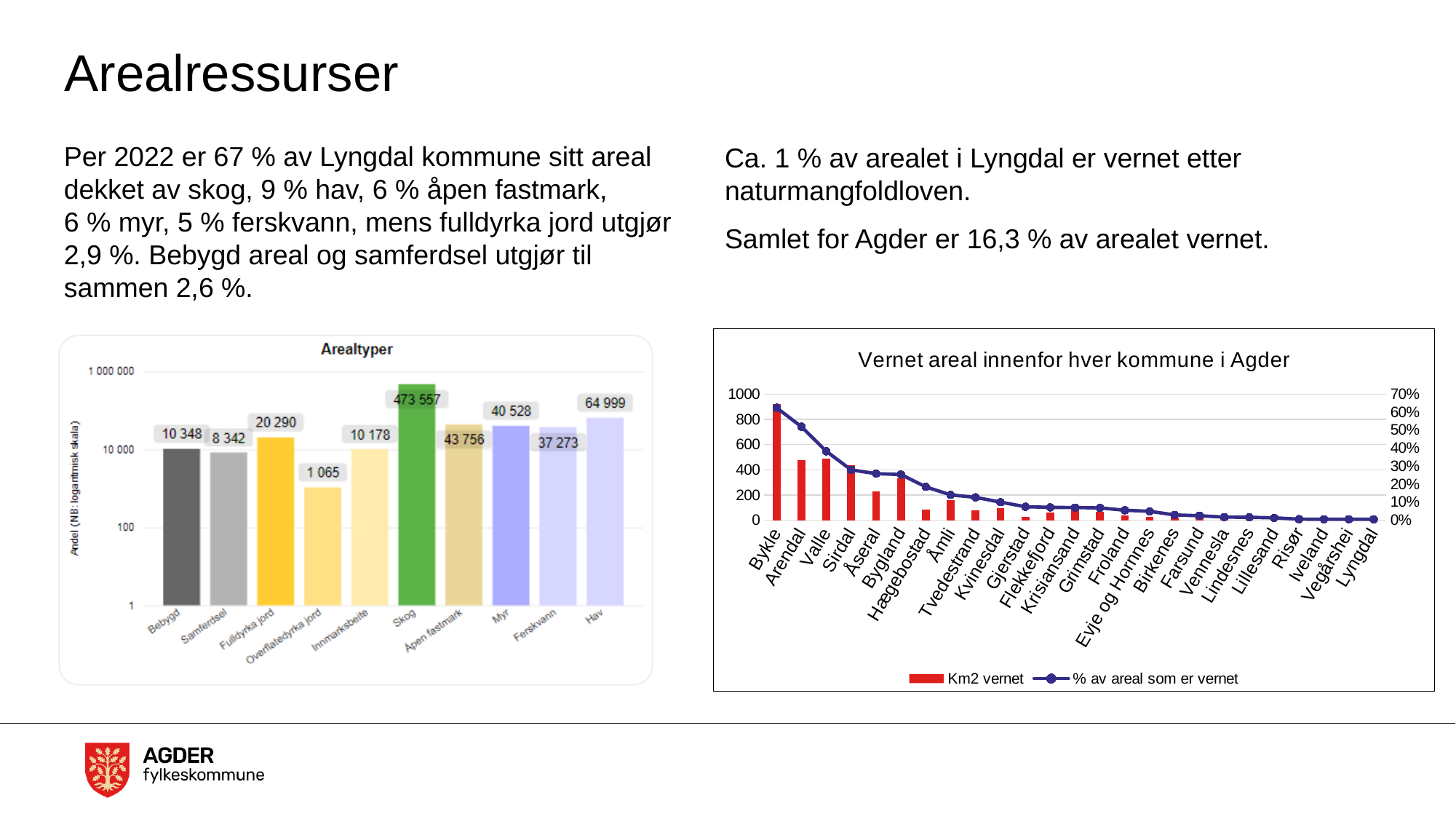
In the Arealtyper chart, which category has the lowest value? Overflatedyrka jord In the chart 'Vernet areal innenfor hver kommune i Agder', is the Km2 vernet value for Bykle greater or less than 800? greater What kind of chart is the Arealtyper chart? Bar chart In the Arealtyper chart, what is the value for Skog? 473 557 In the chart 'Vernet areal innenfor hver kommune i Agder', which kommune has the highest Km2 vernet? Bykle In the Arealtyper chart, which category has the highest value? Skog In the Arealtyper chart, which is larger, Myr or Ferskvann? Myr How many categories are shown in the Arealtyper chart? 10 In the Arealtyper chart, what is the difference between the values for Bebygd and Samferdsel? 2 006 In the Arealtyper chart, what is the value for Overflatedyrka jord? 1 065 How many series does the legend of the chart 'Vernet areal innenfor hver kommune i Agder' list? 2 In the Arealtyper chart, what is the value for Hav? 64 999